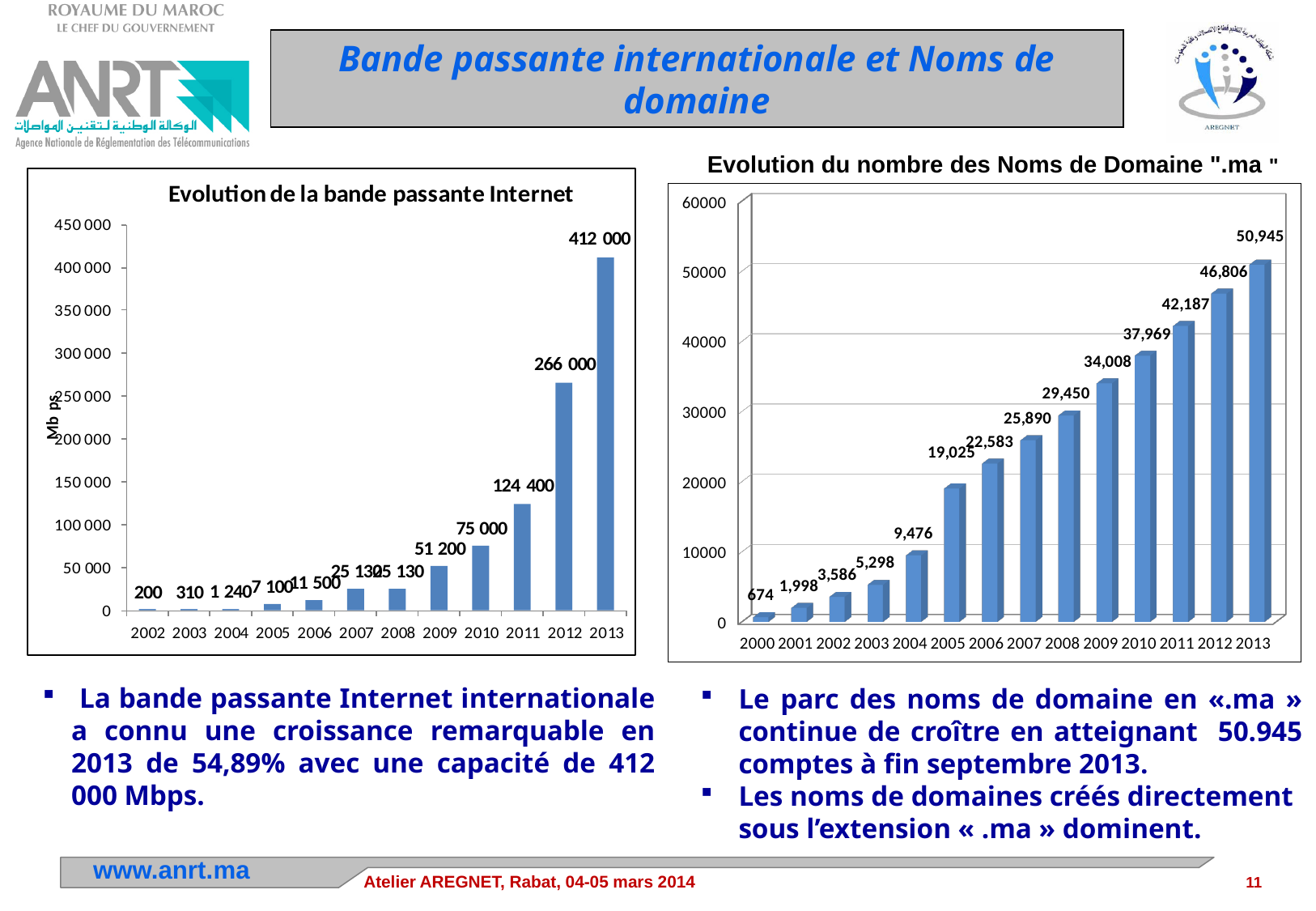
In the chart 'Evolution de la bande passante Internet', what is the value for 2011? 124 400 In the chart 'Evolution de la bande passante Internet', what is the value for 2013? 412 000 In the chart 'Evolution du nombre des Noms de Domaine ".ma"', do the values rise or fall from 2000 to 2013? rise In the chart 'Evolution de la bande passante Internet', what is the label on the vertical axis? Mb ps In the chart 'Evolution du nombre des Noms de Domaine ".ma"', what is the value for 2013? 50,945 In the chart 'Evolution du nombre des Noms de Domaine ".ma"', what is the difference between the 2013 and 2012 values? 4,139 In the chart 'Evolution de la bande passante Internet', which year has the lowest value? 2002 In the chart 'Evolution de la bande passante Internet', what is the difference between the 2013 and 2012 values? 146 000 In the chart 'Evolution de la bande passante Internet', how many years are shown on the x axis? 12 In the chart 'Evolution du nombre des Noms de Domaine ".ma"', which year has the highest value? 2013 In the chart 'Evolution du nombre des Noms de Domaine ".ma"', what is the value for 2005? 19,025 What kind of chart is 'Evolution du nombre des Noms de Domaine ".ma"'? bar chart